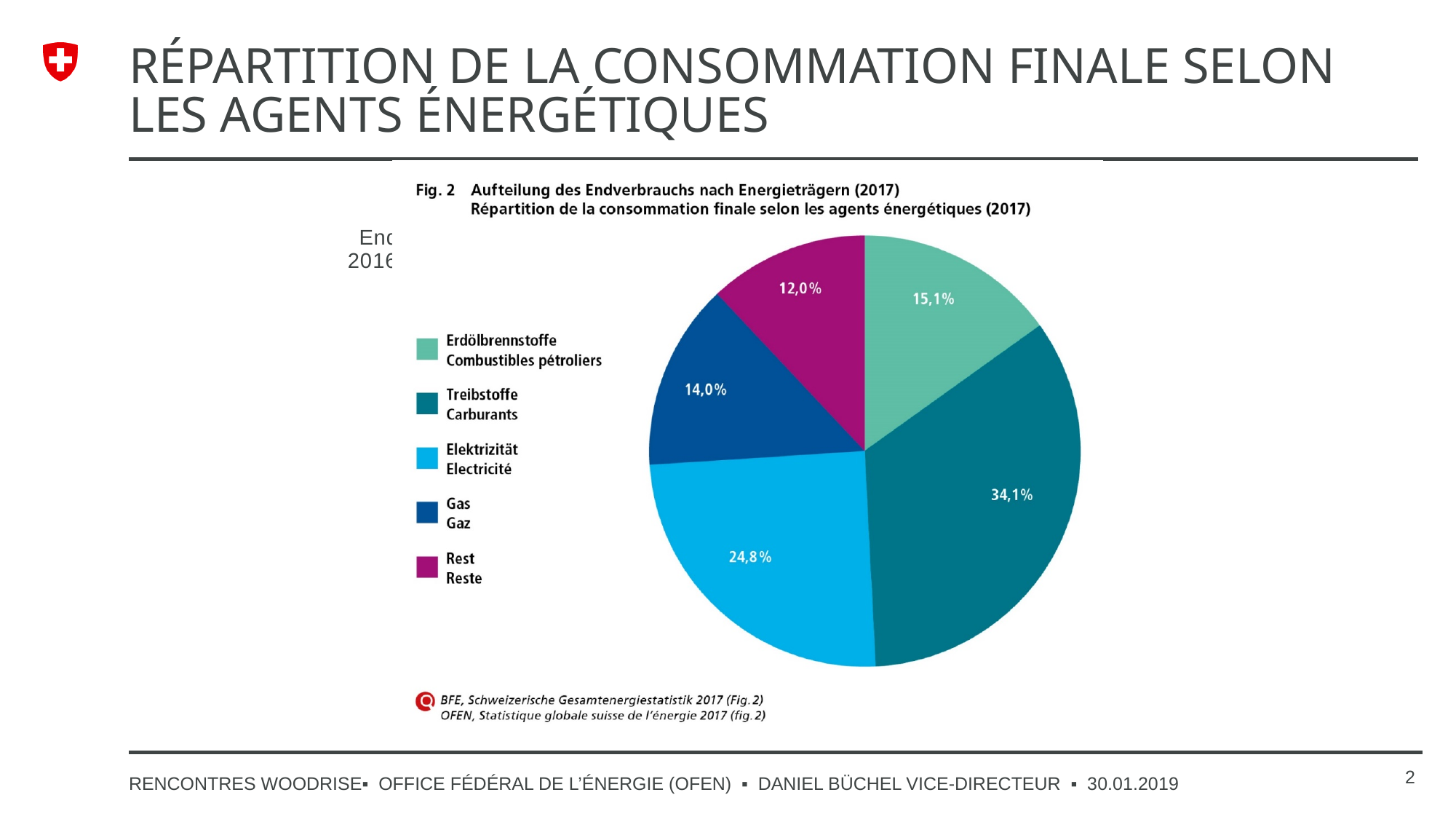
What share of final consumption is Electricité (Elektrizität)? 24,8% What share of final consumption is Combustibles pétroliers (Erdölbrennstoffe)? 15,1% What share of final consumption is Gaz (Gas)? 14,0% Which energy agent has the largest share of final consumption? Carburants (Treibstoffe) What share of final consumption is Reste (Rest)? 12,0% What kind of chart is shown on the slide? pie chart How many slices does the pie chart have? 5 What share of final consumption is Carburants (Treibstoffe)? 34,1% Which has a larger share, Combustibles pétroliers or Gaz? Combustibles pétroliers Which energy agent has the smallest share of final consumption? Reste (Rest) What is the difference in percentage points between the Carburants share and the Electricité share? 9,3 Which year does the pie chart's data refer to, according to its title? 2017